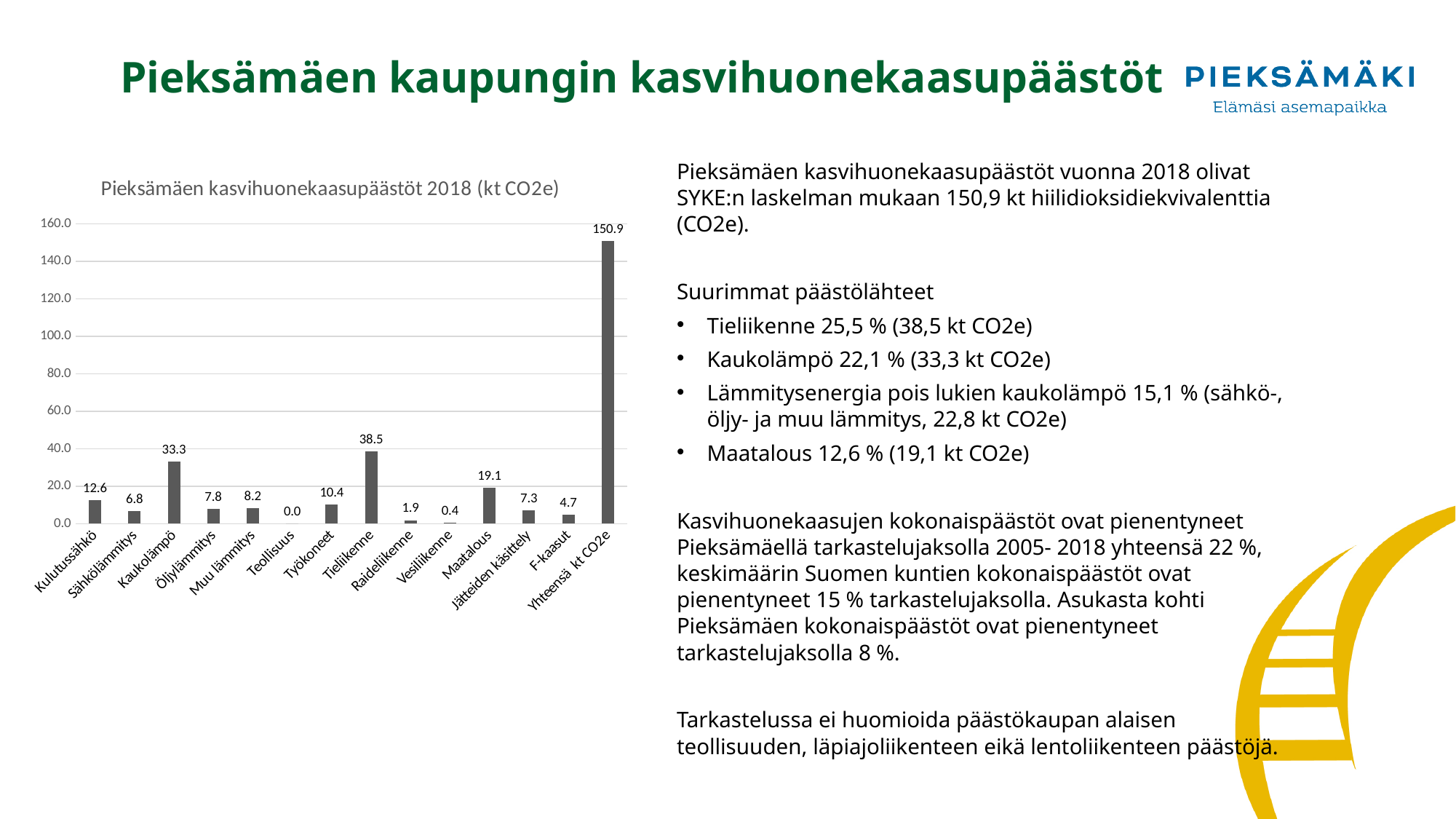
Which is larger, the value for Kulutussähkö or the value for Työkoneet? Kulutussähkö What is the value shown for Yhteensä kt CO2e? 150.9 Which category has the lowest value in the chart? Teollisuus What is the difference between the values for Tieliikenne and Kaukolämpö? 5.2 What is the value for Tieliikenne in the chart? 38.5 What is the value for Kaukolämpö in the chart? 33.3 What is the value for Maatalous in the chart? 19.1 How many categories are shown on the x axis of the chart? 14 Excluding the total bar (Yhteensä kt CO2e), which category has the highest value? Tieliikenne What kind of chart is shown on the slide? Bar chart What is the title of the chart? Pieksämäen kasvihuonekaasupäästöt 2018 (kt CO2e) What is the value for Teollisuus in the chart? 0.0